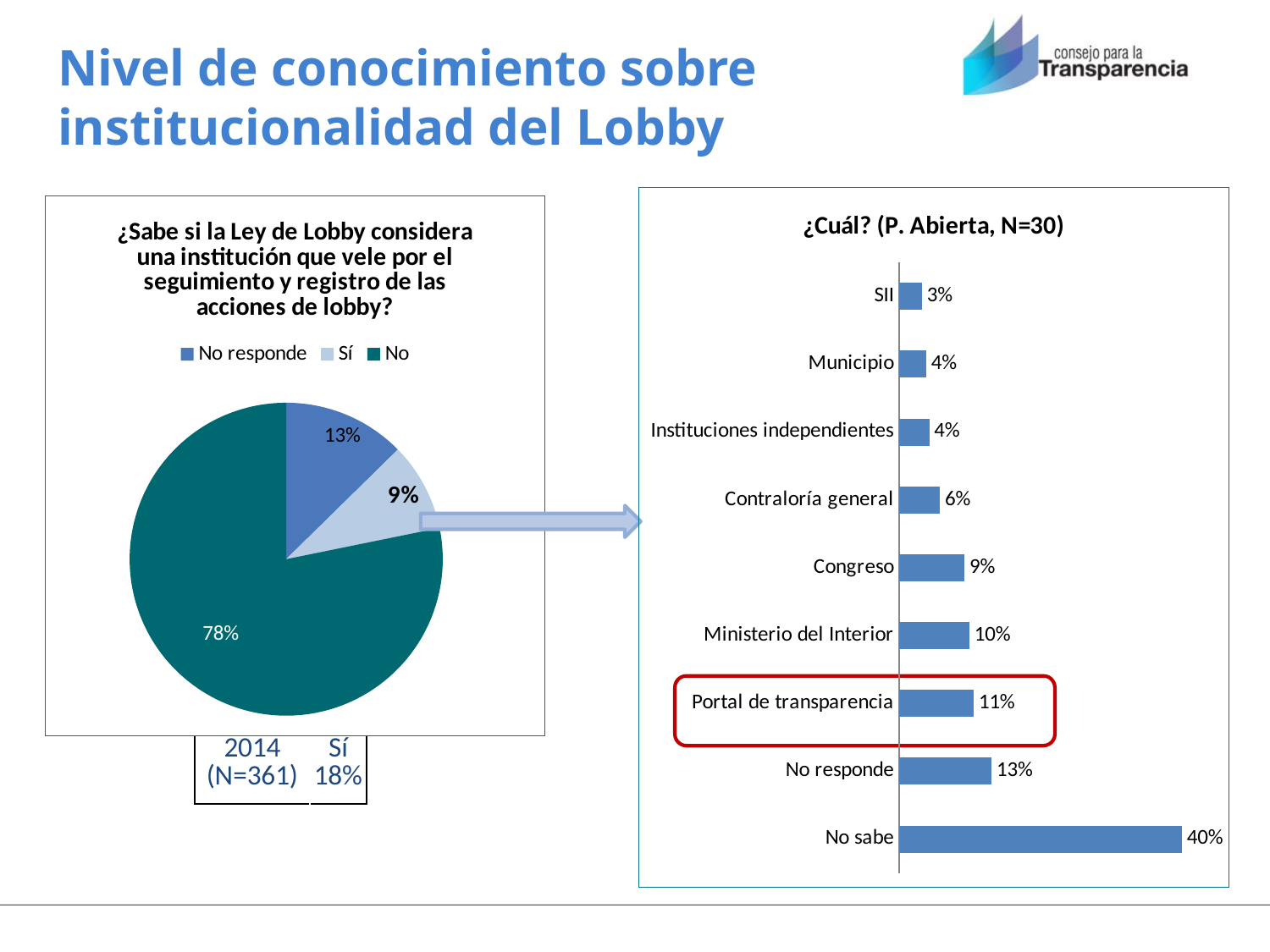
In the chart titled "¿Cuál? (P. Abierta, N=30)", which category has the lowest value? SII What kind of chart is the one titled "¿Cuál? (P. Abierta, N=30)"? Bar chart In the chart titled "¿Cuál? (P. Abierta, N=30)", how many categories are shown? 9 In the chart titled "¿Cuál? (P. Abierta, N=30)", what is the value for "Contraloría general"? 6% In the chart titled "¿Cuál? (P. Abierta, N=30)", what is the difference between "No sabe" and "No responde"? 27% In the pie chart on the left, what share corresponds to "No responde"? 13% In the pie chart on the left, which is larger, "No responde" or "Sí"? No responde In the chart titled "¿Cuál? (P. Abierta, N=30)", what is the value for "Portal de transparencia"? 11% In the chart titled "¿Cuál? (P. Abierta, N=30)", which category has the highest value? No sabe In the pie chart on the left, what share of respondents answered "Sí"? 9% In the pie chart on the left, what share of respondents answered "No"? 78% In the pie chart on the left, how many entries does the legend list? 3